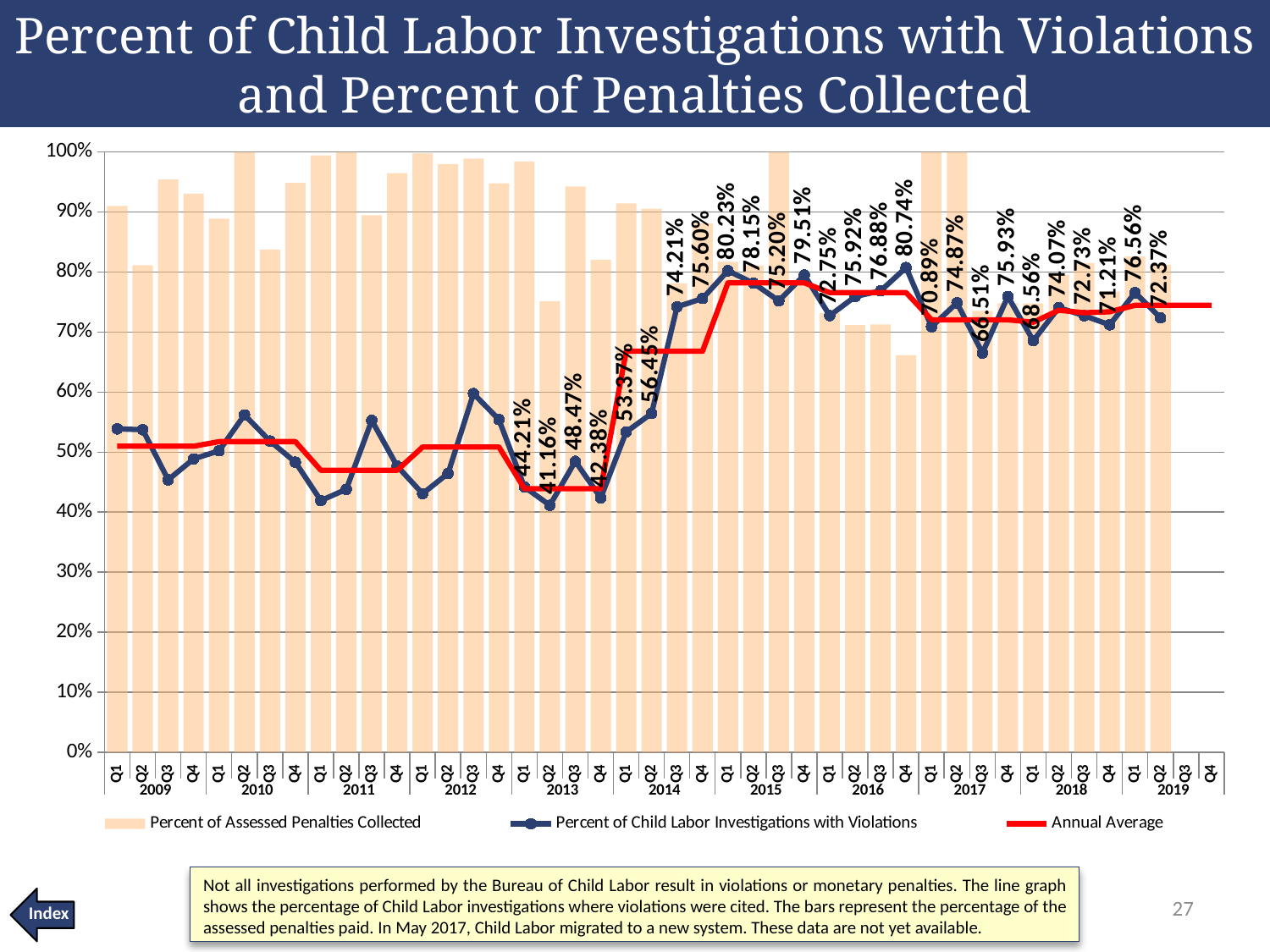
What is the difference between the Percent of Child Labor Investigations with Violations in Q1 2015 and Q1 2013? 36.02% Does the Percent of Child Labor Investigations with Violations rise or fall from Q4 2013 to Q1 2015? Rise Is the Percent of Assessed Penalties Collected bar for Q4 2016 greater or less than 70%? less Is the Percent of Assessed Penalties Collected bar for Q2 2013 greater or less than 80%? less Among the quarters with data labels, which quarter has the highest Percent of Child Labor Investigations with Violations? Q4 2016 Among the quarters with data labels, which quarter has the lowest Percent of Child Labor Investigations with Violations? Q2 2013 What is the Percent of Child Labor Investigations with Violations for Q2 2013? 41.16% How many series does the legend list? 3 What kind of chart is shown on the slide? Combined bar and line chart What is the Percent of Child Labor Investigations with Violations for Q4 2016? 80.74% What is the Percent of Child Labor Investigations with Violations for Q2 2019? 72.37% Which quarter has a higher Percent of Child Labor Investigations with Violations, Q3 2017 or Q4 2017? Q4 2017